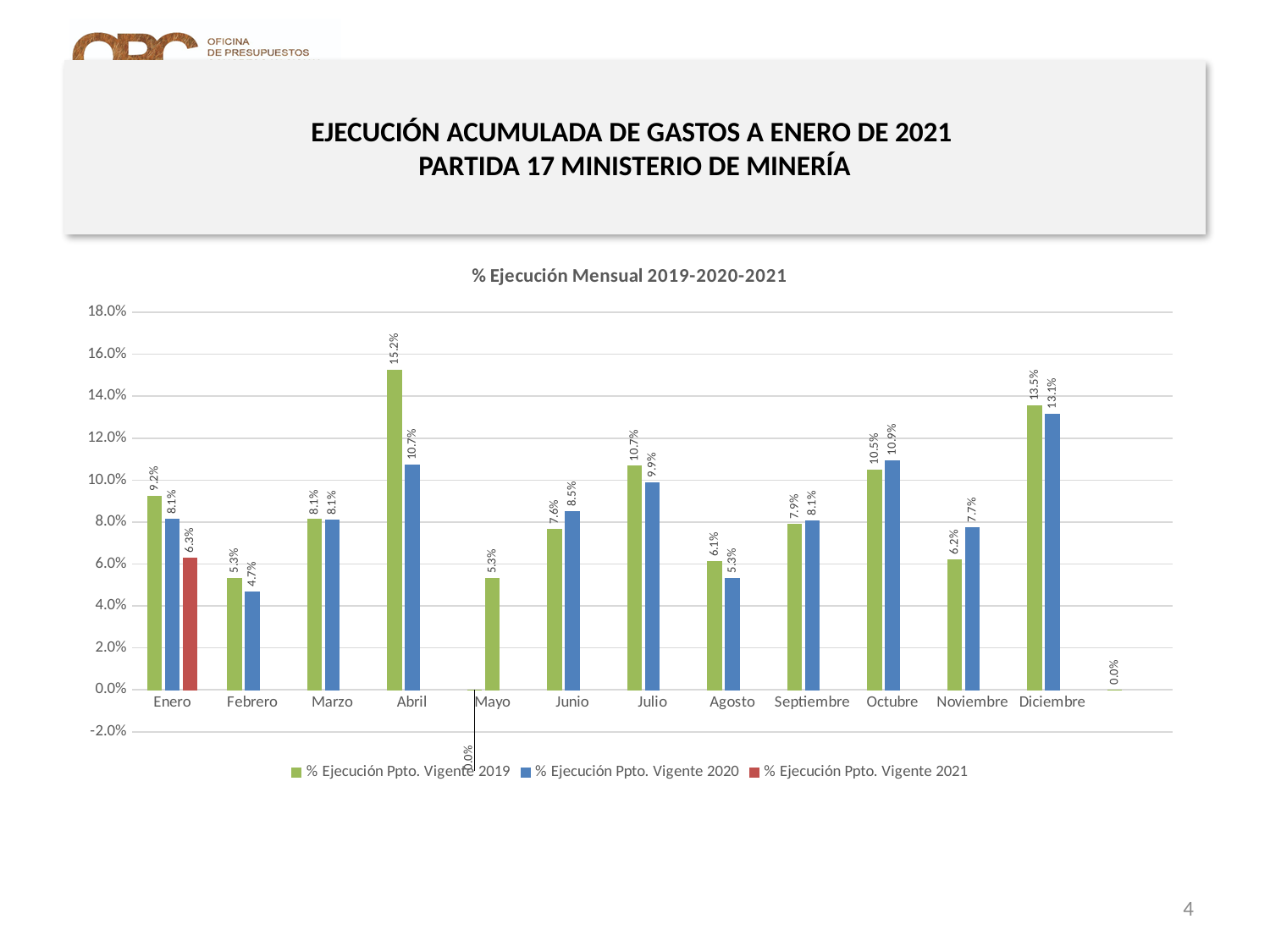
How many series does the legend list? 3 What is the value for Enero in the % Ejecución Ppto. Vigente 2021 series? 6.3% Which month has the highest value in the % Ejecución Ppto. Vigente 2019 series? Abril Which month has the highest value in the % Ejecución Ppto. Vigente 2020 series? Diciembre What is the difference between the 2019 and 2021 values for Enero? 2.9 percentage points For Octubre, which series has the larger value, 2019 or 2020? % Ejecución Ppto. Vigente 2020 What kind of chart is shown on the slide? Bar chart What is the difference between the 2019 and 2020 values for Abril? 4.5 percentage points What is the value for Abril in the % Ejecución Ppto. Vigente 2019 series? 15.2% What is the title of the chart? % Ejecución Mensual 2019-2020-2021 How many months are shown on the x axis? 12 What is the value for Julio in the % Ejecución Ppto. Vigente 2020 series? 9.9%